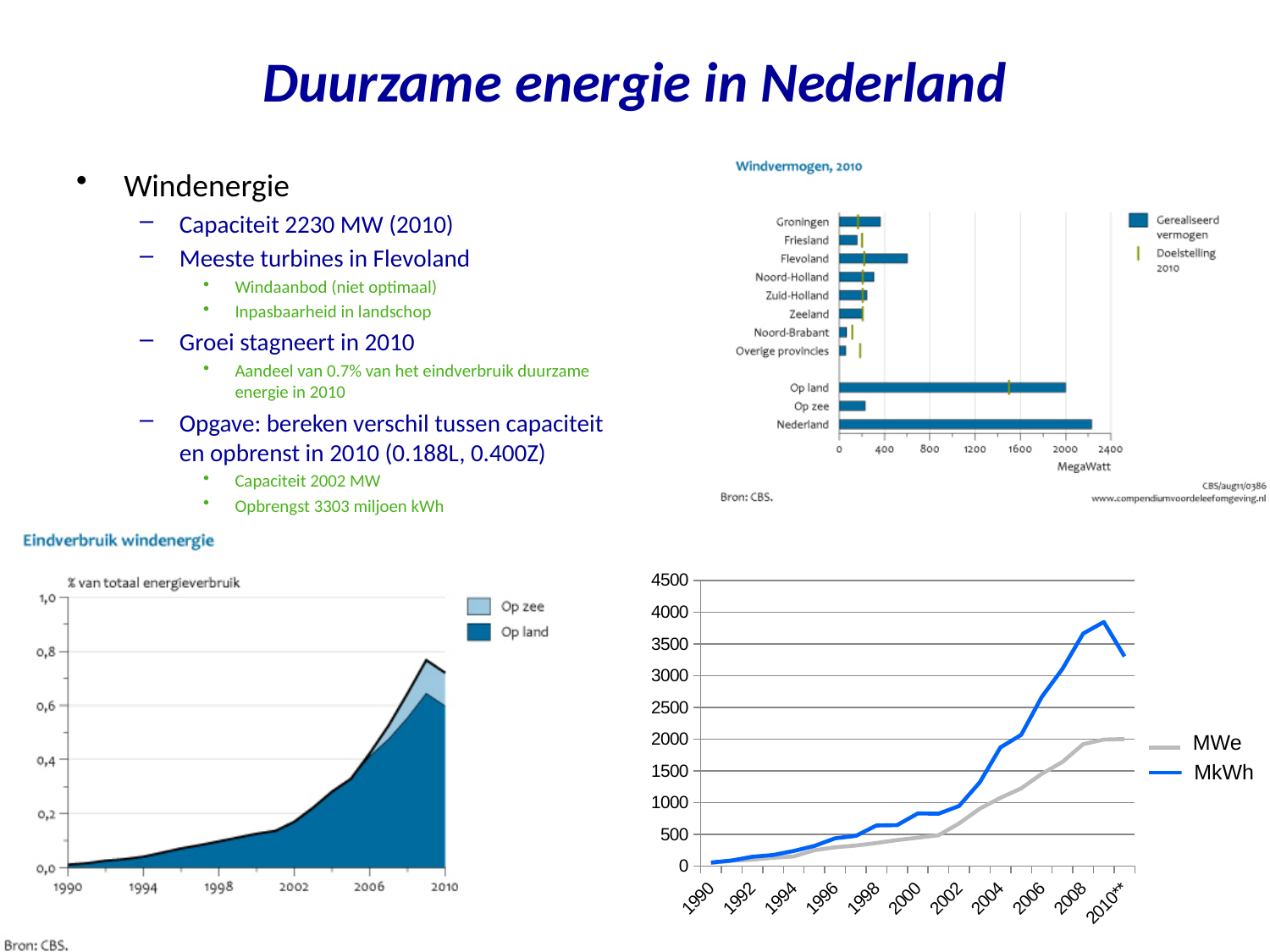
How many series does the legend of the 'Eindverbruik windenergie' chart list? 2 How many series does the legend of the line chart at the bottom right list? 2 What kind of chart is the 'Windvermogen, 2010' chart? bar chart In the 'Windvermogen, 2010' chart, which province has the highest realised wind capacity? Flevoland In the 'Eindverbruik windenergie' chart, do the values rise or fall from 1990 to 2010? rise In the 'Windvermogen, 2010' chart, is the value for Op zee greater or less than 400 MegaWatt? less In the 'Windvermogen, 2010' chart, is the value for Flevoland greater or less than 400 MegaWatt? greater In the 'Windvermogen, 2010' chart, is the value for Nederland greater or less than 2000 MegaWatt? greater In the 'Windvermogen, 2010' chart, what unit is shown on the horizontal axis? MegaWatt In the 'Windvermogen, 2010' chart, which is larger, the bar for Op land or the bar for Op zee? Op land